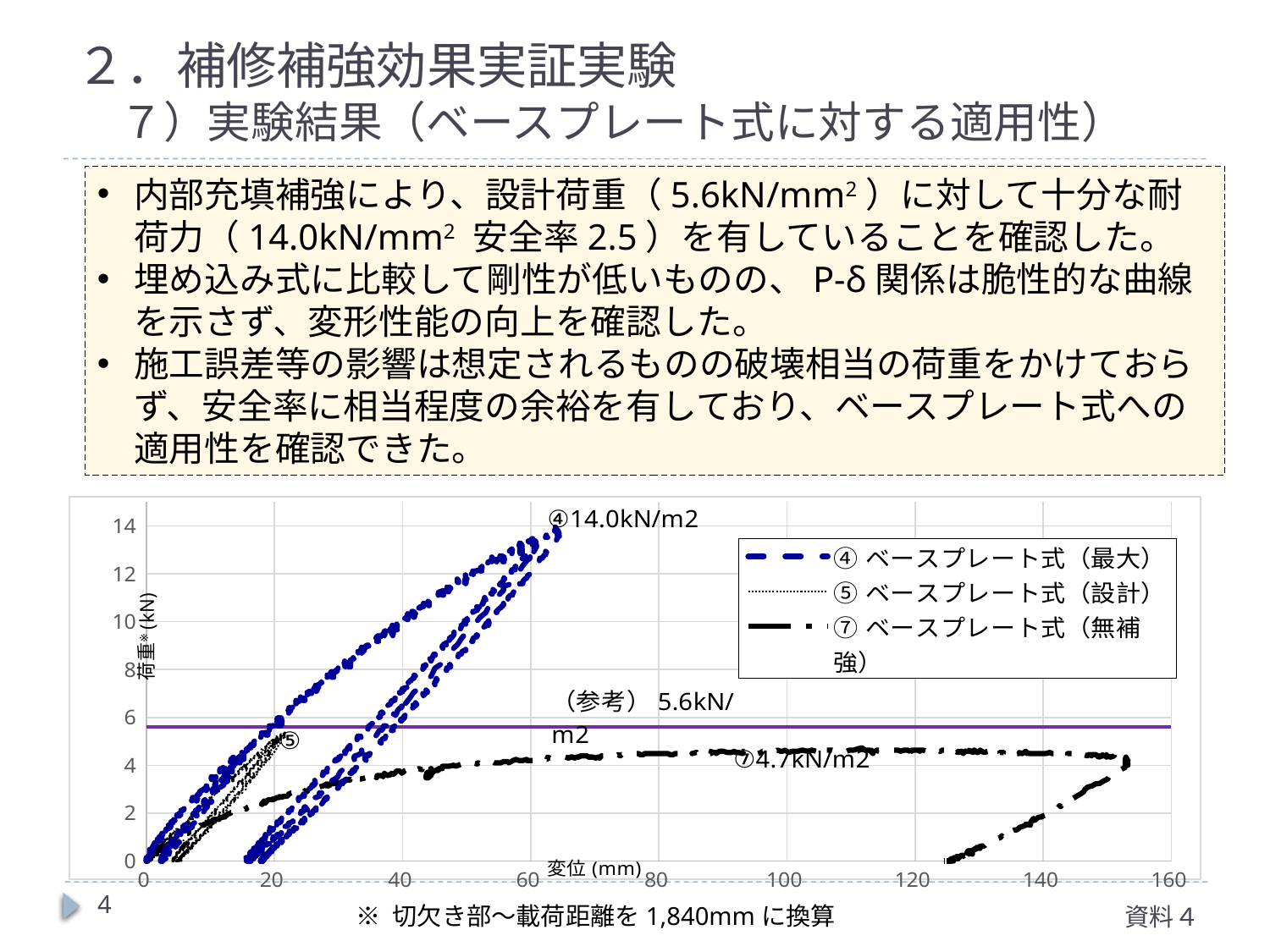
Which series has the lowest peak load? ⑦ ベースプレート式（無補強） Which is larger, the labelled load for ④ or the labelled load for ⑦? ④ How many series does the legend list? 3 Is the maximum displacement reached by series ⑦ greater or less than 140 mm? greater What value is given for the horizontal reference line labelled （参考）? 5.6kN/m2 Which series reaches the highest load? ④ ベースプレート式（最大） What is the difference between the labelled load for ④ (14.0kN/m2) and the labelled load for ⑦ (4.7kN/m2)? 9.3kN/m2 What kind of chart is shown on the slide? line chart Is the peak load of series ⑤ ベースプレート式（設計） greater or less than 4 kN? greater What load value is labelled for series ⑦ ベースプレート式（無補強）? 4.7kN/m2 What is the label of the x axis? 変位 (mm) What maximum load value is labelled for series ④ ベースプレート式（最大）? 14.0kN/m2